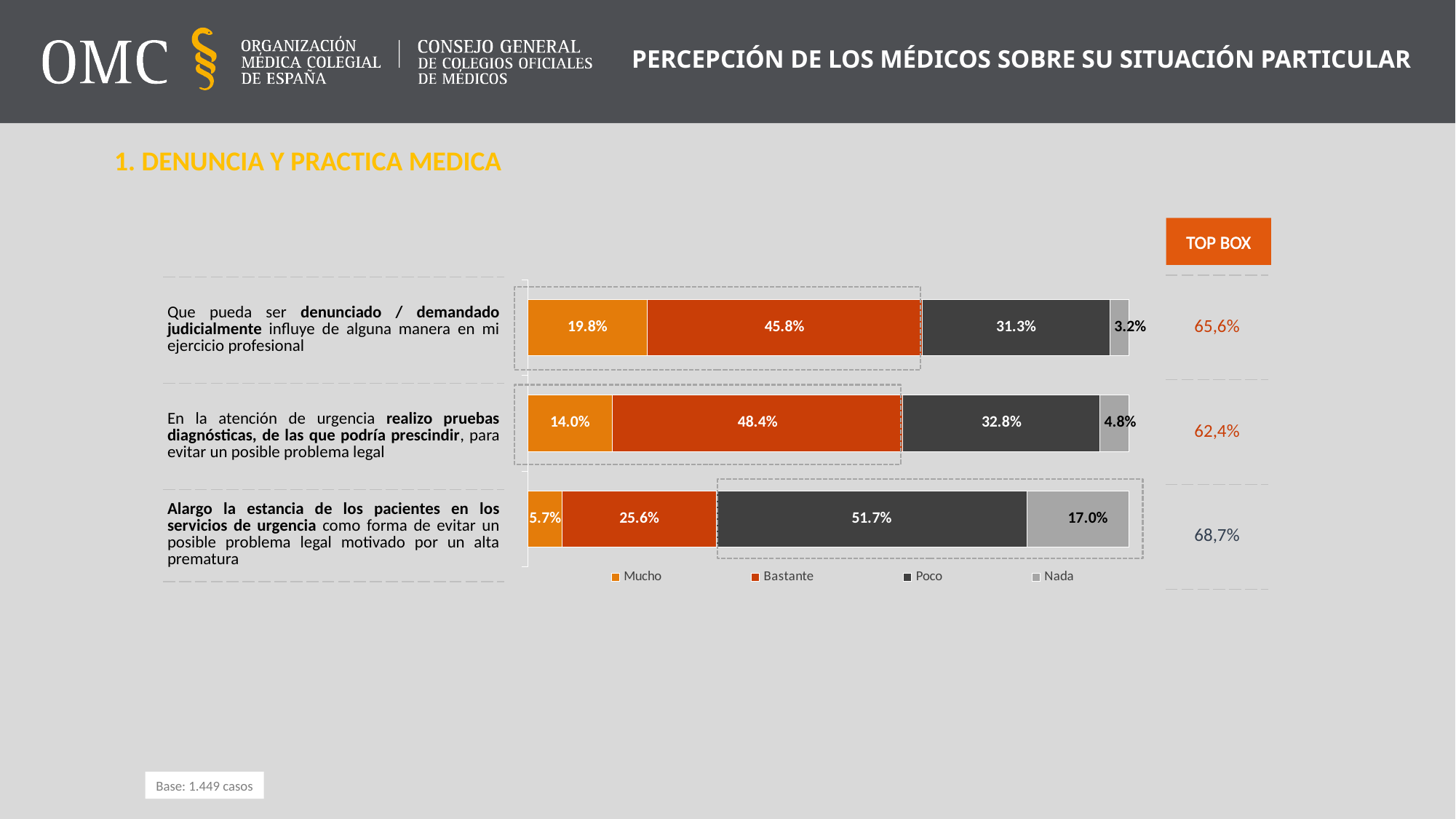
For the statement 'Alargo la estancia de los pacientes en los servicios de urgencia', what is the difference between the 'Poco' and 'Bastante' values? 26.1% Which statement has the lowest 'Bastante' value? Alargo la estancia de los pacientes en los servicios de urgencia como forma de evitar un posible problema legal motivado por un alta prematura What is the 'Nada' value for the statement 'En la atención de urgencia realizo pruebas diagnósticas, de las que podría prescindir'? 4.8% What kind of chart is shown on the slide? Stacked bar chart How many statements (bars) are plotted in the chart? 3 Is the 'Nada' value larger for the first statement (denunciado / demandado judicialmente) or the third statement (Alargo la estancia de los pacientes)? The third statement (Alargo la estancia de los pacientes) What is the total of the stacked bar for the statement 'En la atención de urgencia realizo pruebas diagnósticas, de las que podría prescindir'? 100.0% What is the 'Bastante' value for the statement about being 'denunciado / demandado judicialmente'? 45.8% What is the 'Poco' value for the statement 'Alargo la estancia de los pacientes en los servicios de urgencia'? 51.7% What is the TOP BOX value shown for the statement 'En la atención de urgencia realizo pruebas diagnósticas, de las que podría prescindir'? 62,4% How many series does the legend list? 4 Which statement has the highest 'Mucho' value? Que pueda ser denunciado / demandado judicialmente influye de alguna manera en mi ejercicio profesional